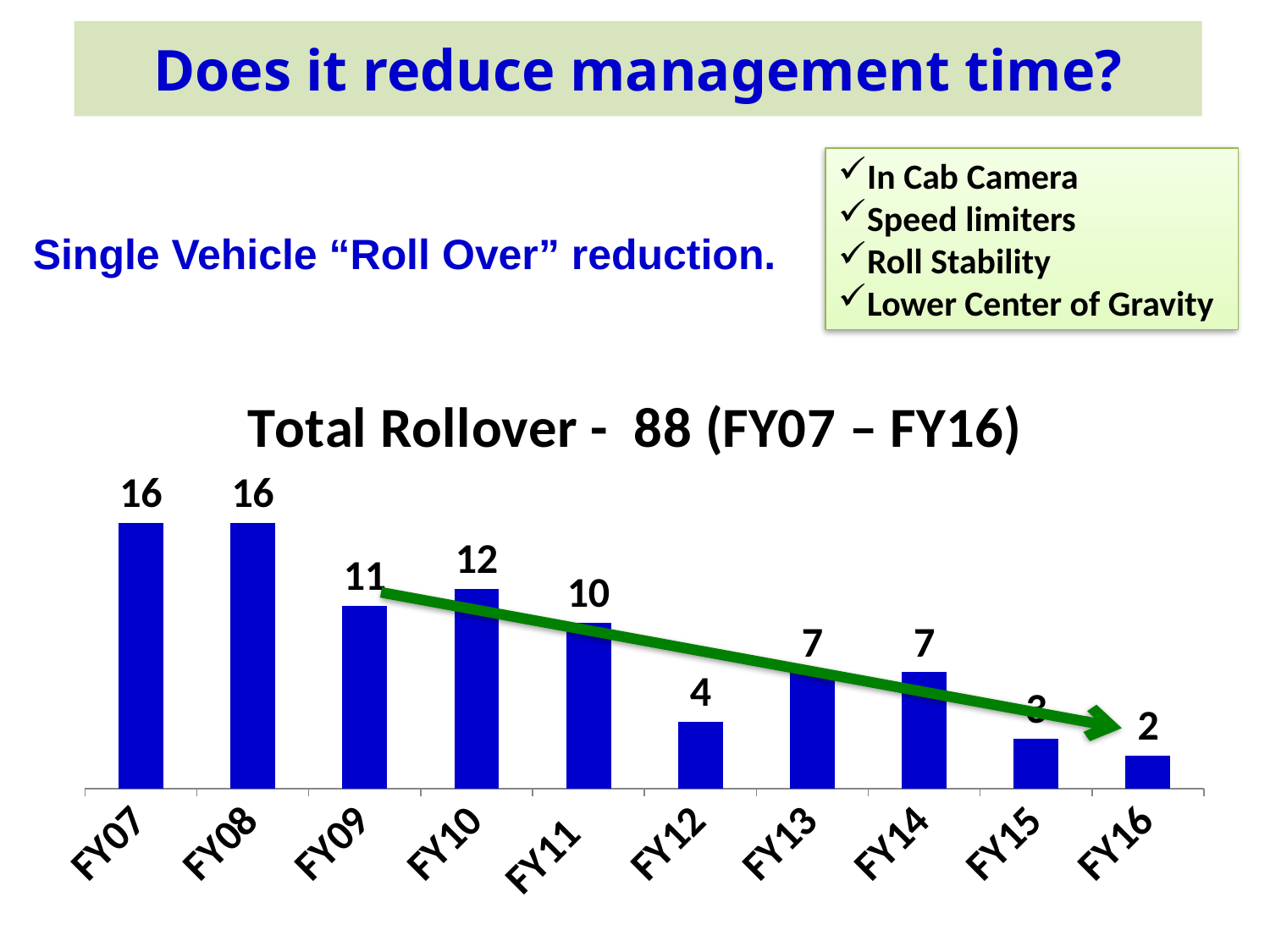
What is the difference between the values for FY07 and FY16? 14 How many fiscal years are shown on the x axis? 10 Do the values generally rise or fall from FY07 to FY16? fall What is the value for FY10? 12 What is the difference between the values for FY10 and FY11? 2 What is the title of the chart? Total Rollover - 88 (FY07 – FY16) What is the value for FY12? 4 What is the value for FY16? 2 Which fiscal year has the lowest value? FY16 Which is larger, the value for FY09 or the value for FY10? FY10 What kind of chart is shown on the slide? bar chart What is the value for FY07? 16